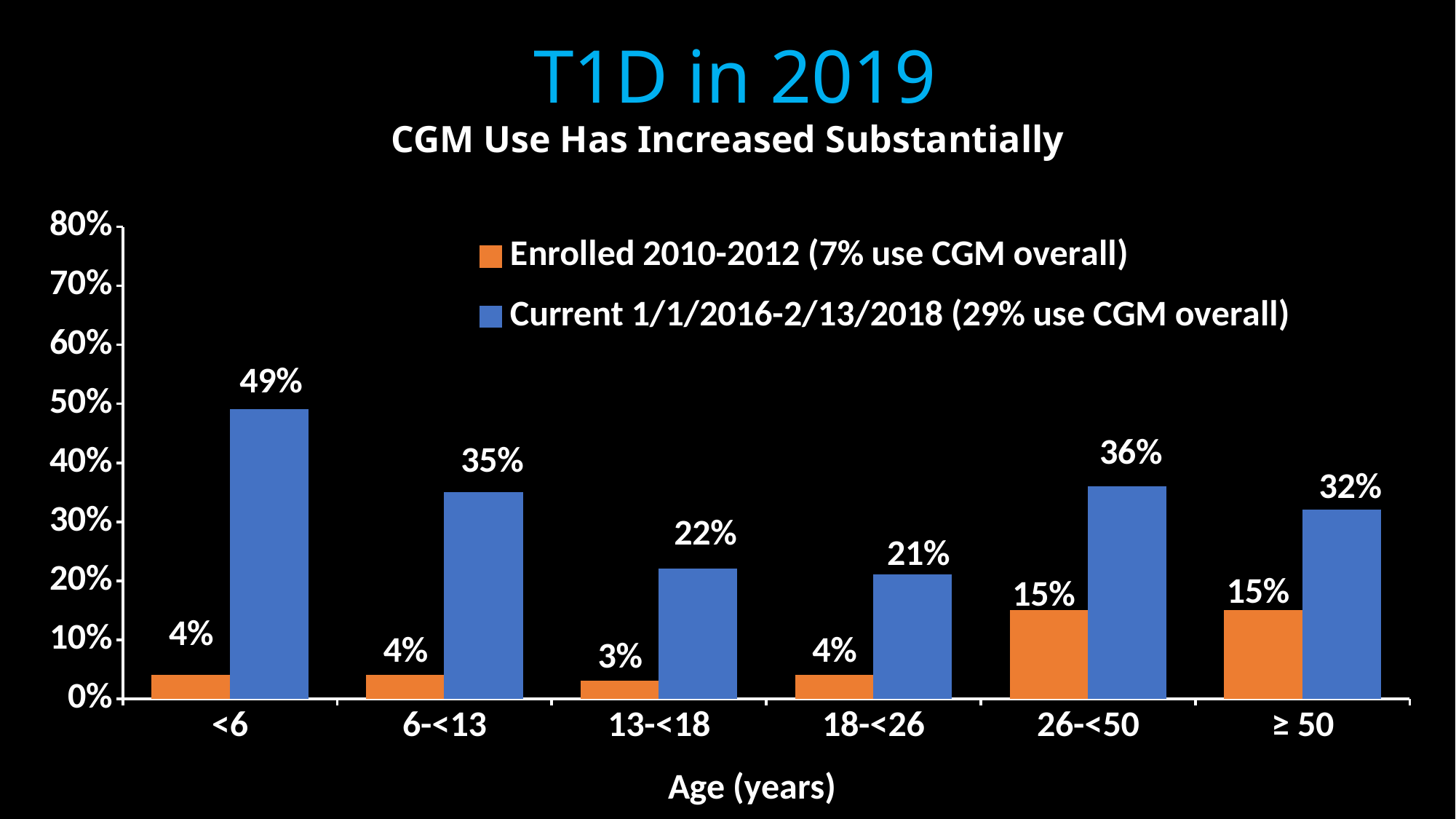
Which age group has the highest value in the Current 1/1/2016-2/13/2018 series? <6 Which is larger for the ≥ 50 age group: the Enrolled 2010-2012 value or the Current 1/1/2016-2/13/2018 value? Current 1/1/2016-2/13/2018 What is the x-axis label of the chart? Age (years) Which age group has the lowest value in the Enrolled 2010-2012 series? 13-<18 What is the difference between the Current and Enrolled 2010-2012 values for the <6 age group? 45% What kind of chart is shown on the slide? bar chart What is the value for the 13-<18 age group in the Enrolled 2010-2012 series? 3% What is the value for the 26-<50 age group in the Enrolled 2010-2012 series? 15% What is the value for the <6 age group in the Current 1/1/2016-2/13/2018 series? 49% How many age groups are shown on the x axis? 6 How many series does the legend list? 2 Is the Current 1/1/2016-2/13/2018 value for the 6-<13 age group greater or less than 30%? greater